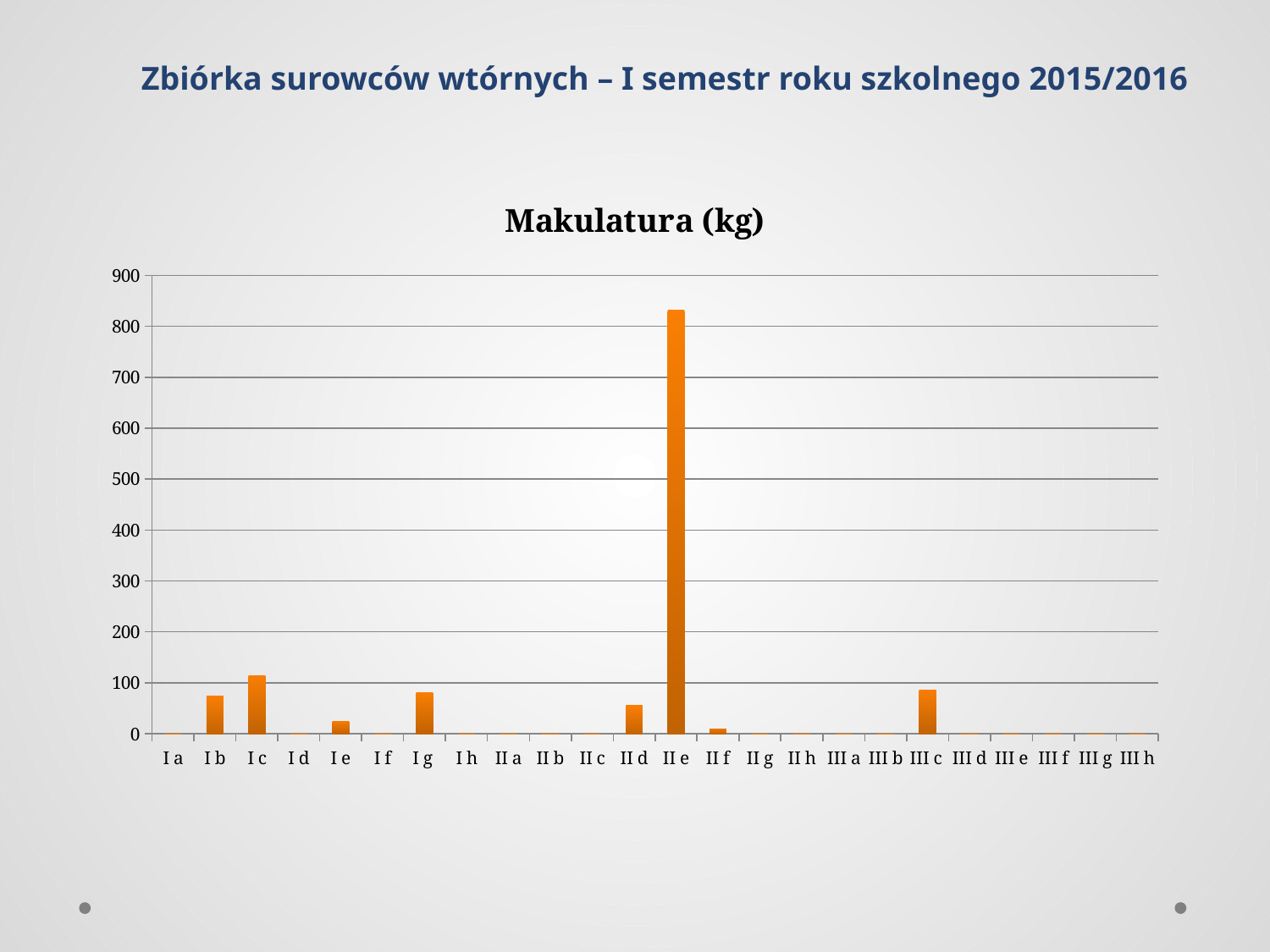
Is the value for III c greater or less than 100? less What kind of chart is shown on the slide? bar chart Is the value for II e greater or less than 800? greater Is the value for I c greater or less than 100? greater What is the title of the chart? Makulatura (kg) Which is larger, the value for I c or the value for I b? I c Which is larger, the value for I g or the value for I e? I g Which is larger, the value for II e or the value for III c? II e How many categories are shown on the x axis of the chart? 24 Which category has the highest value in the chart? II e